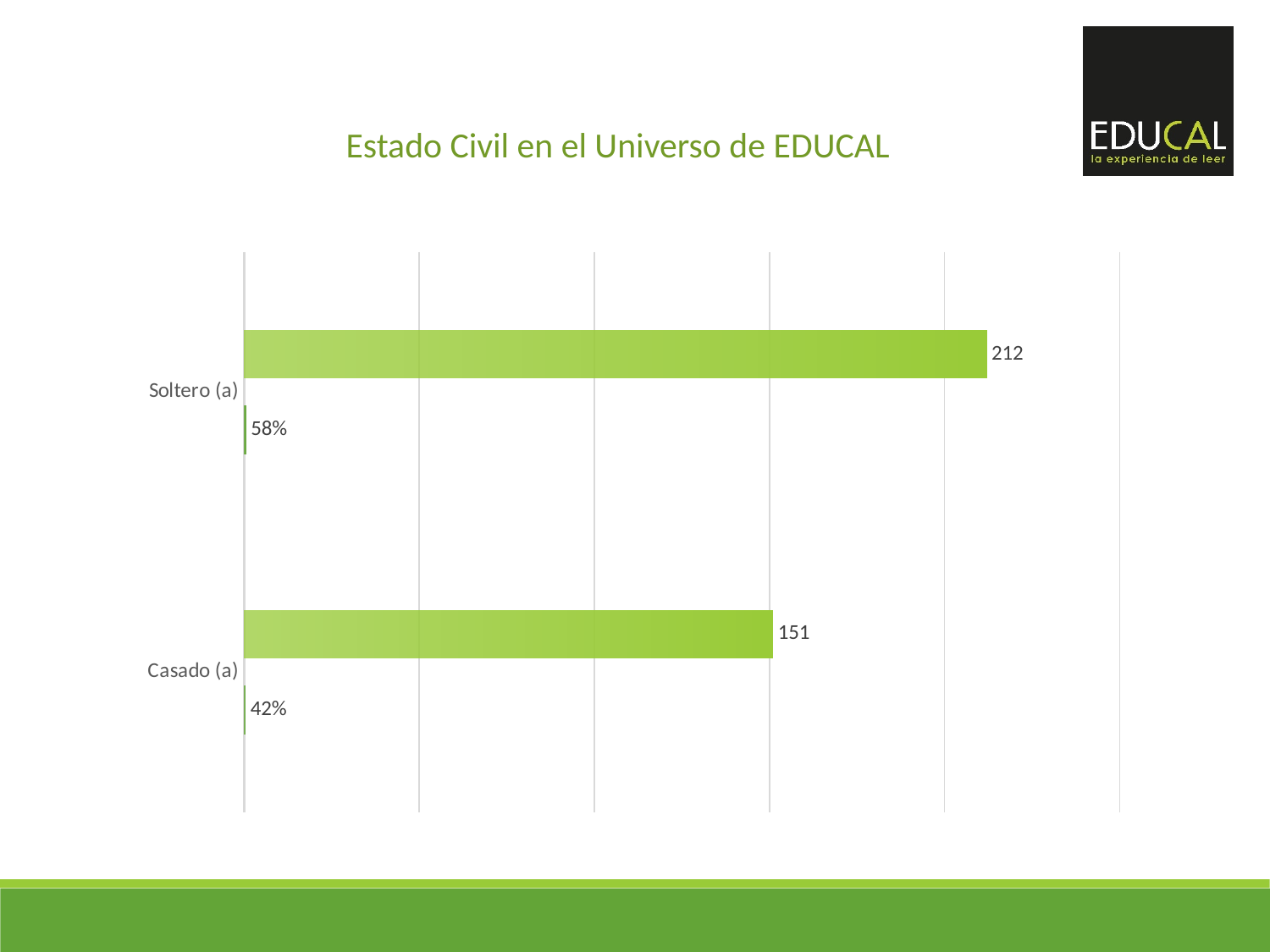
What percentage is shown for Soltero (a)? 58% Which marital status category has the highest count? Soltero (a) What percentage is shown for Casado (a)? 42% What is the title of the chart? Estado Civil en el Universo de EDUCAL What is the difference between the counts for Soltero (a) and Casado (a)? 61 What is the count value shown for Soltero (a)? 212 What is the difference between the percentages for Soltero (a) and Casado (a)? 16% What is the count value shown for Casado (a)? 151 Which is larger, the count for Soltero (a) or the count for Casado (a)? Soltero (a) How many marital status categories are shown in the chart? 2 What kind of chart is shown on the slide? Bar chart Which marital status category has the lowest count? Casado (a)